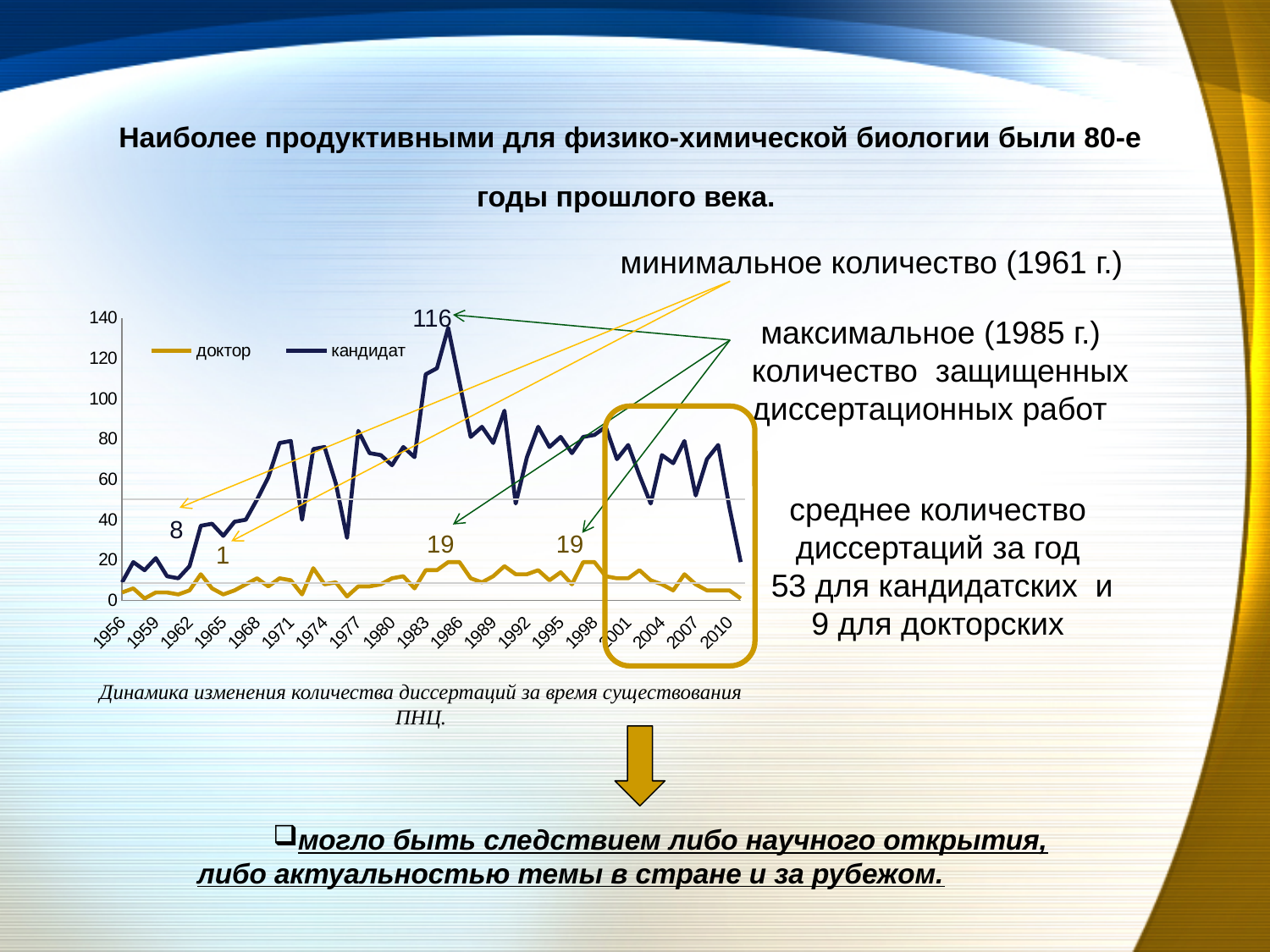
What is the labelled value of the доктор series in 1961? 1 What are the two series named in the chart legend? доктор and кандидат What is the highest labelled value of the кандидат series? 116 What is the value of the кандидат series in 1985, the year of the maximum? 116 How many series does the chart legend list? 2 What is the labelled value of the кандидат series in 1961, the year of the minimum? 8 What is the difference between the кандидат value (116) and the доктор value (19) at the 1985 peak? 97 What kind of chart is shown on the slide? line chart Is the highest value of the доктор series greater or less than 40? less Does the кандидат series generally rise or fall from 1956 to 1985? rise What is the difference between the кандидат value (8) and the доктор value (1) in 1961? 7 Which series has the larger value in 1985, доктор or кандидат? кандидат